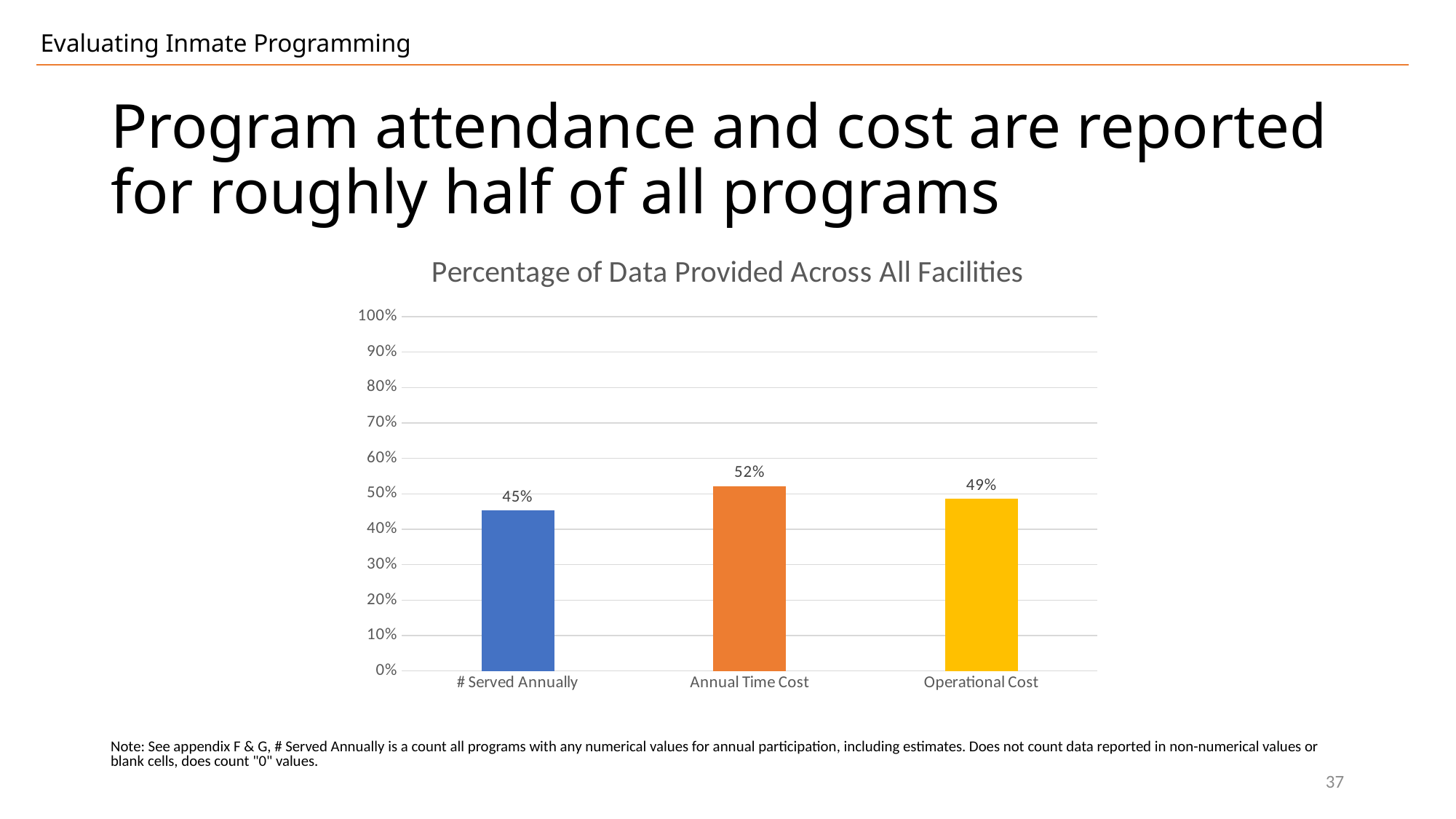
What kind of chart is shown on the slide? bar chart What is the difference between the values for Annual Time Cost and # Served Annually? 7% Which category has the highest value? Annual Time Cost Which category has the lowest value? # Served Annually What is the title of the chart? Percentage of Data Provided Across All Facilities What is the value for Annual Time Cost? 52% What is the difference between the values for Operational Cost and # Served Annually? 4% Which is larger, the value for Operational Cost or the value for # Served Annually? Operational Cost Is the value for Annual Time Cost greater or less than 50%? greater What is the value for Operational Cost? 49% What is the value for # Served Annually? 45% How many categories are shown on the chart? 3